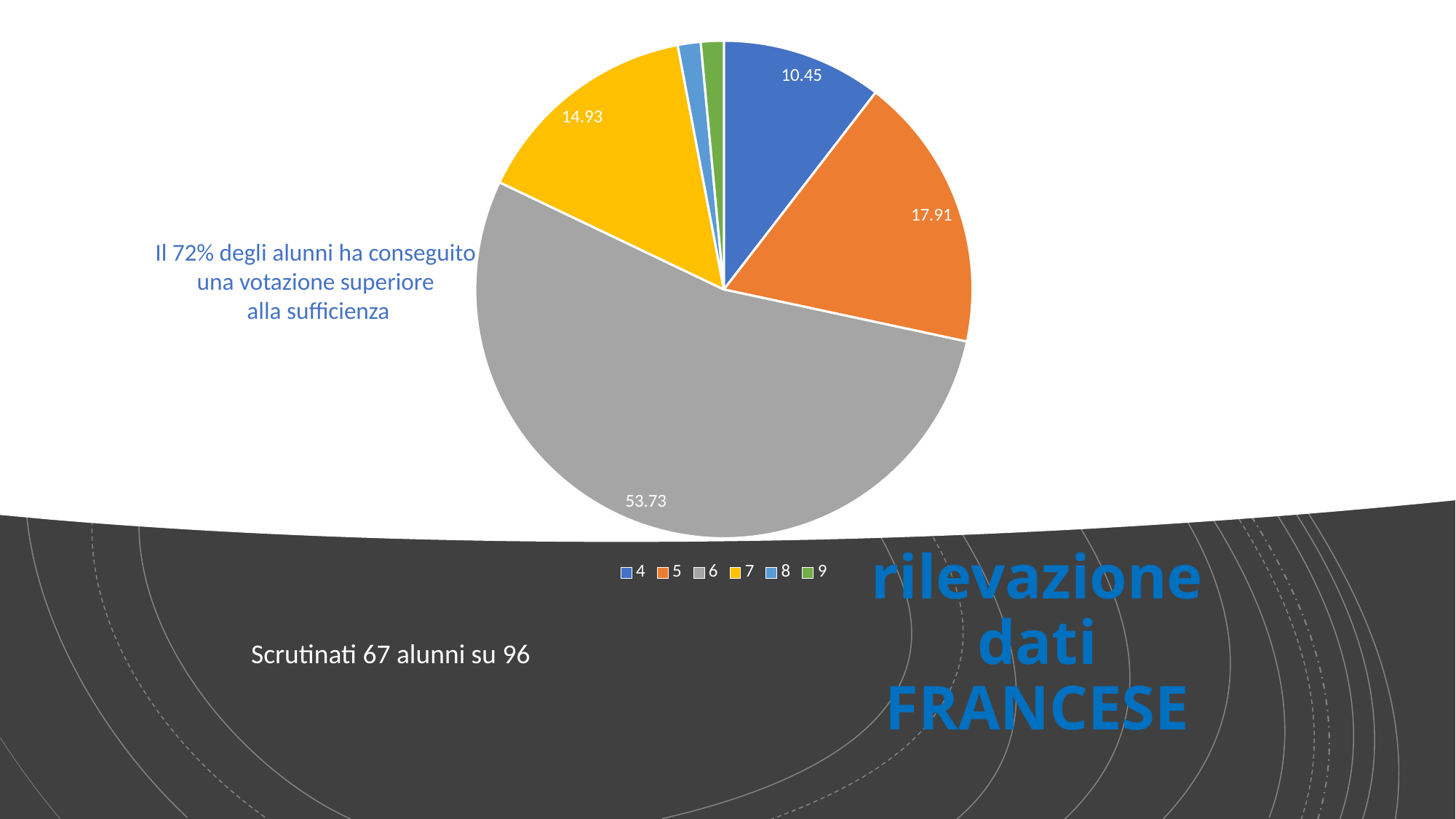
What is the difference between the values for category 6 and category 7? 38.8 What is the difference between the values for category 5 and category 4? 7.46 Which category has the largest slice in the pie chart? 6 Which is larger, the slice for category 5 or the slice for category 7? 5 How many categories does the legend of the pie chart list? 6 What colour is the slice for category 6 in the pie chart? Gray What is the value shown for category 7 in the pie chart? 14.93 What type of chart is shown on the slide? Pie chart What is the value shown for category 6 in the pie chart? 53.73 What is the value shown for category 4 in the pie chart? 10.45 Which is larger, the slice for category 4 or the slice for category 7? 7 What is the value shown for category 5 in the pie chart? 17.91